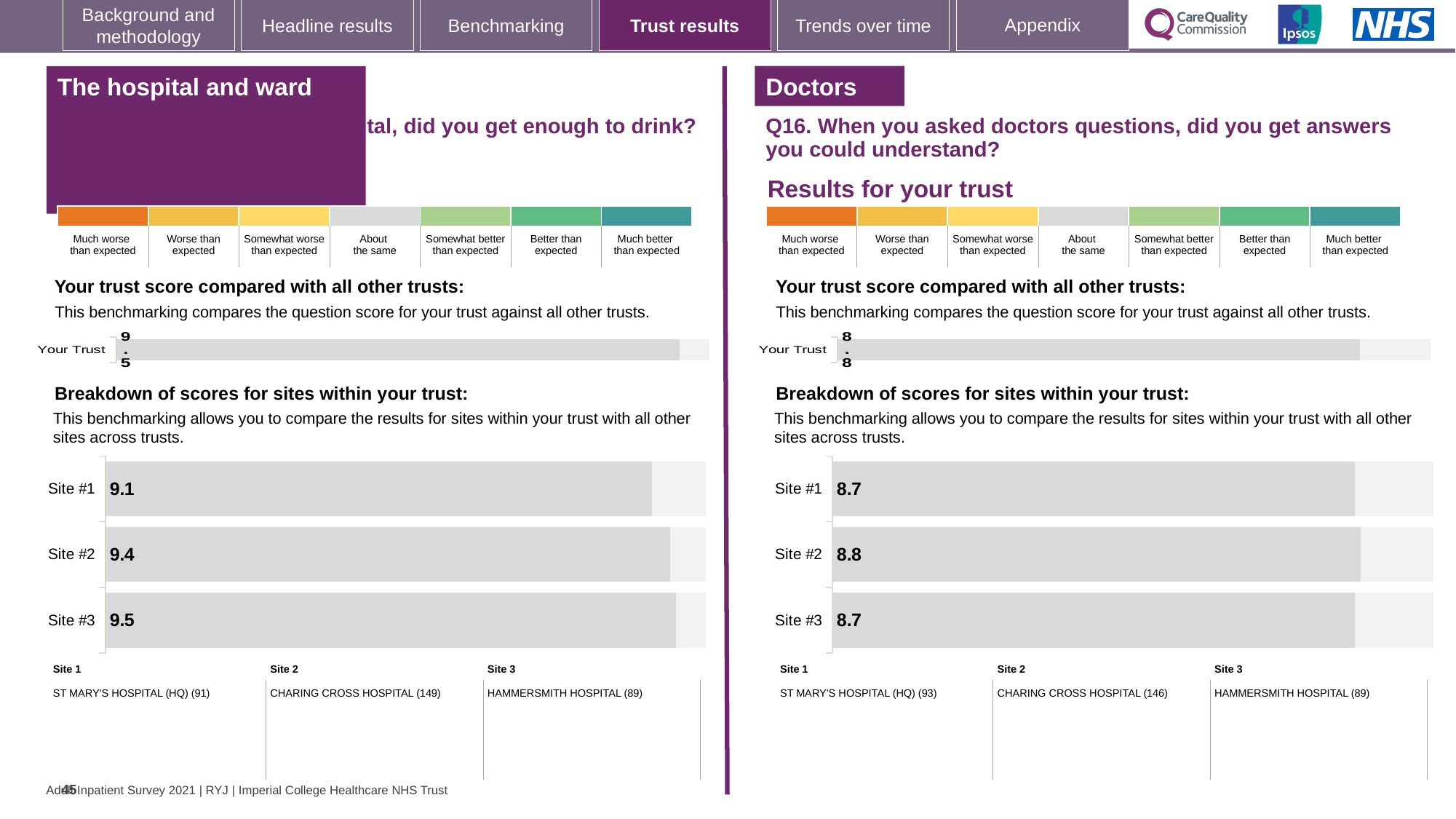
In the site breakdown chart on the left (The hospital and ward), which site has the highest score? Site #3 How many sites are plotted in the site breakdown chart on the right (Doctors, Q16)? 3 In the site breakdown chart on the left (The hospital and ward), which site has the lowest score? Site #1 What type of chart is used for the site breakdown on the left (The hospital and ward)? Bar chart In the site breakdown chart on the left (The hospital and ward), what is the difference between the scores for Site #3 and Site #1? 0.4 In the site breakdown chart on the right (Doctors, Q16), which site has the highest score? Site #2 Which is larger: the Site #2 score in the left site breakdown chart or the Site #2 score in the right site breakdown chart? The left chart (9.4) In the site breakdown chart on the right (Doctors, Q16), what is the score for Site #2? 8.8 In the site breakdown chart on the right (Doctors, Q16), what is the difference between the scores for Site #2 and Site #1? 0.1 In the 'Your Trust' chart on the right (Doctors, Q16), what is the trust score shown? 8.8 In the 'Your Trust' chart on the left (The hospital and ward), what is the trust score shown? 9.5 In the site breakdown chart on the left (The hospital and ward), what is the score for Site #2? 9.4